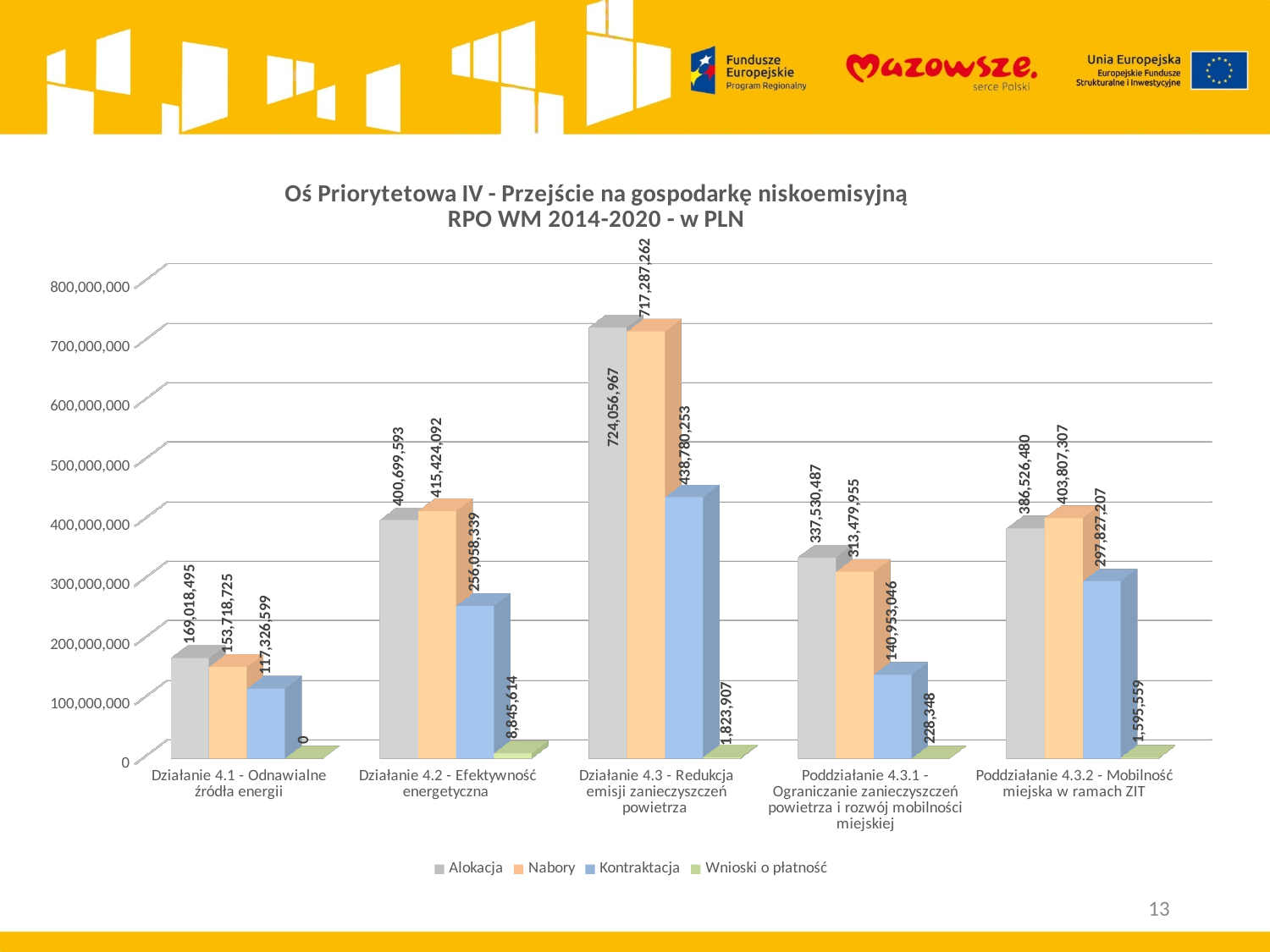
How many categories are shown on the x axis? 5 What is the Alokacja value for Działanie 4.3 - Redukcja emisji zanieczyszczeń powietrza? 724,056,967 What is the difference between Alokacja and Nabory for Działanie 4.3? 6,769,705 What kind of chart is shown on the slide? bar chart What is the Nabory value for Poddziałanie 4.3.2 - Mobilność miejska w ramach ZIT? 403,807,307 What is the Kontraktacja value for Działanie 4.2 - Efektywność energetyczna? 256,058,339 For Działanie 4.2, which is larger: Alokacja or Nabory? Nabory Is the Kontraktacja value for Działanie 4.3 greater or less than 400,000,000? greater Which category has the lowest Kontraktacja value? Działanie 4.1 - Odnawialne źródła energii Which category has the highest Alokacja value? Działanie 4.3 - Redukcja emisji zanieczyszczeń powietrza What is the Wnioski o płatność value for Poddziałanie 4.3.1? 228,348 How many series does the legend list? 4